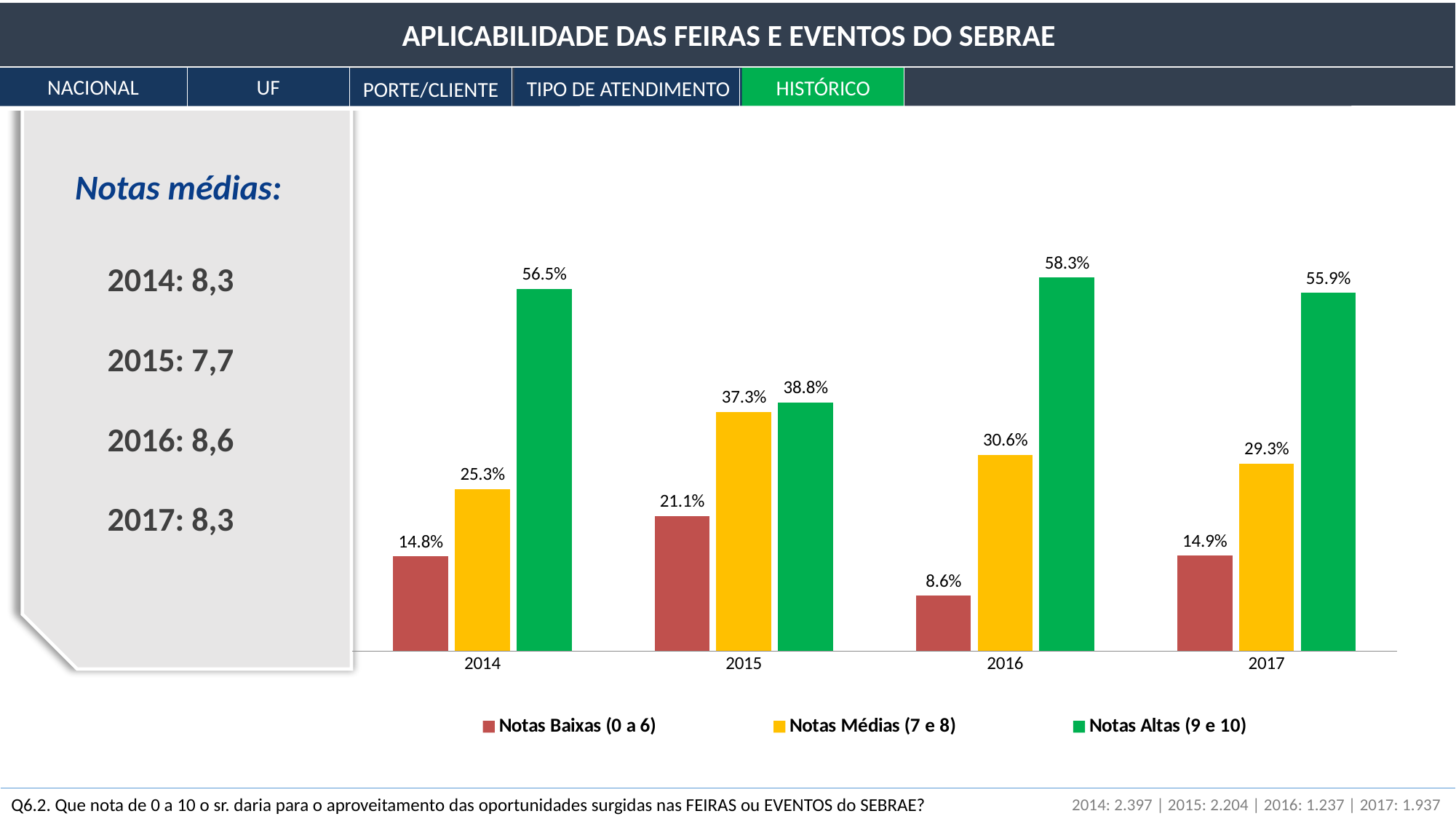
Which is larger in 2015: Notas Médias (7 e 8) or Notas Altas (9 e 10)? Notas Altas (9 e 10) What is the value for Notas Altas (9 e 10) in 2016? 58.3% How many series does the legend list? 3 In which year is the Notas Baixas (0 a 6) value highest? 2015 How many years are shown on the x axis? 4 What is the difference between the Notas Altas (9 e 10) values for 2016 and 2015? 19.5% What colour represents Notas Médias (7 e 8) in the legend? yellow What is the value for Notas Médias (7 e 8) in 2017? 29.3% What is the value for Notas Baixas (0 a 6) in 2015? 21.1% In which year is the Notas Altas (9 e 10) value lowest? 2015 What kind of chart is shown? bar chart Does the Notas Baixas (0 a 6) value rise or fall from 2015 to 2016? fall